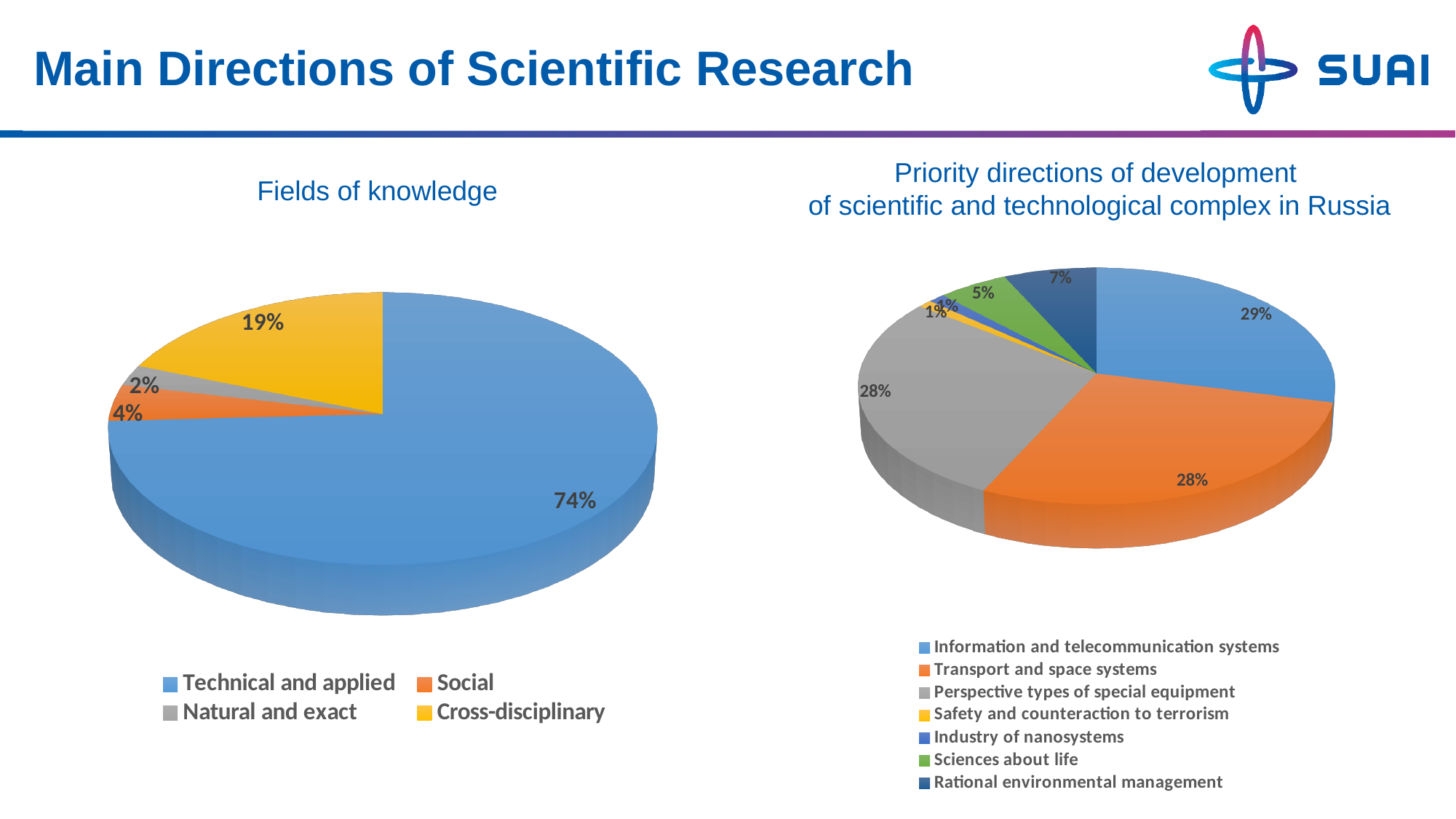
In the 'Priority directions of development' chart, which is larger: Rational environmental management or Sciences about life? Rational environmental management In the 'Priority directions of development' chart, how many categories does the legend list? 7 In the 'Priority directions of development' chart, what share is Sciences about life? 5% In the 'Fields of knowledge' chart, what is the difference between the Technical and applied share and the Cross-disciplinary share? 55% In the 'Fields of knowledge' chart, how many categories does the legend list? 4 In the 'Fields of knowledge' chart, what share is Technical and applied? 74% In the 'Fields of knowledge' chart, what share is Cross-disciplinary? 19% In the 'Fields of knowledge' chart, which category has the smallest share? Natural and exact What kind of chart is the 'Fields of knowledge' chart? Pie chart In the 'Priority directions of development' chart, what share is Information and telecommunication systems? 29% In the 'Fields of knowledge' chart, what share is Social? 4% In the 'Priority directions of development' chart, what share is Rational environmental management? 7%